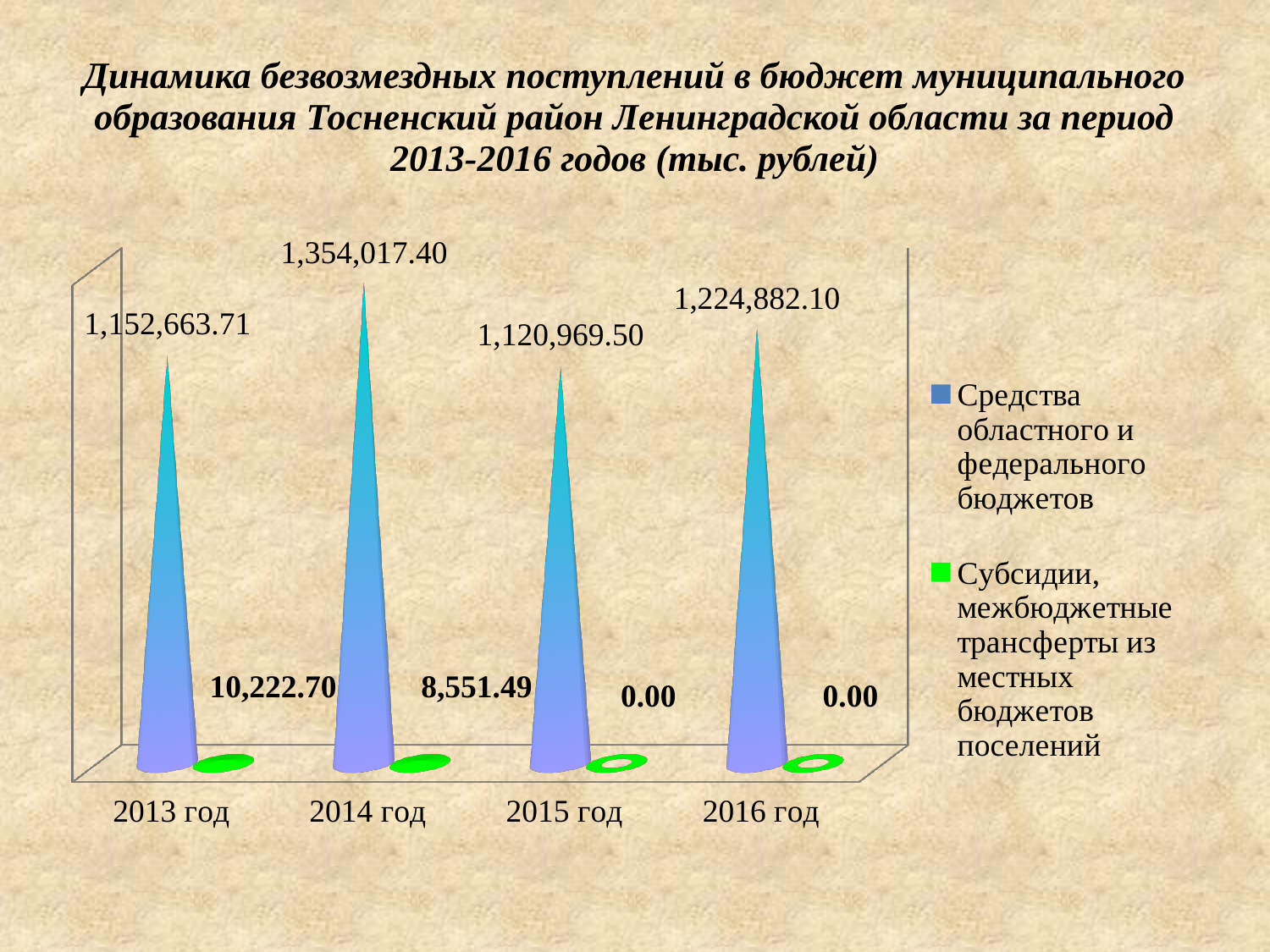
How many years are shown on the x axis? 4 In which year is 'Средства областного и федерального бюджетов' lowest? 2015 год In which year is 'Средства областного и федерального бюджетов' highest? 2014 год What is the difference between the 'Субсидии, межбюджетные трансферты из местных бюджетов поселений' values for 2013 год and 2014 год? 1,671.21 How many series does the legend list? 2 What is the value for 'Субсидии, межбюджетные трансферты из местных бюджетов поселений' in 2016 год? 0.00 What is the difference between the 'Средства областного и федерального бюджетов' values for 2014 год and 2013 год? 201,353.69 Which is larger for 'Средства областного и федерального бюджетов': 2016 год or 2015 год? 2016 год What is the value for 'Субсидии, межбюджетные трансферты из местных бюджетов поселений' in 2013 год? 10,222.70 What is the value for 'Средства областного и федерального бюджетов' in 2015 год? 1,120,969.50 Does the 'Субсидии, межбюджетные трансферты из местных бюджетов поселений' series rise or fall from 2013 год to 2016 год? fall What is the value for 'Средства областного и федерального бюджетов' in 2014 год? 1,354,017.40